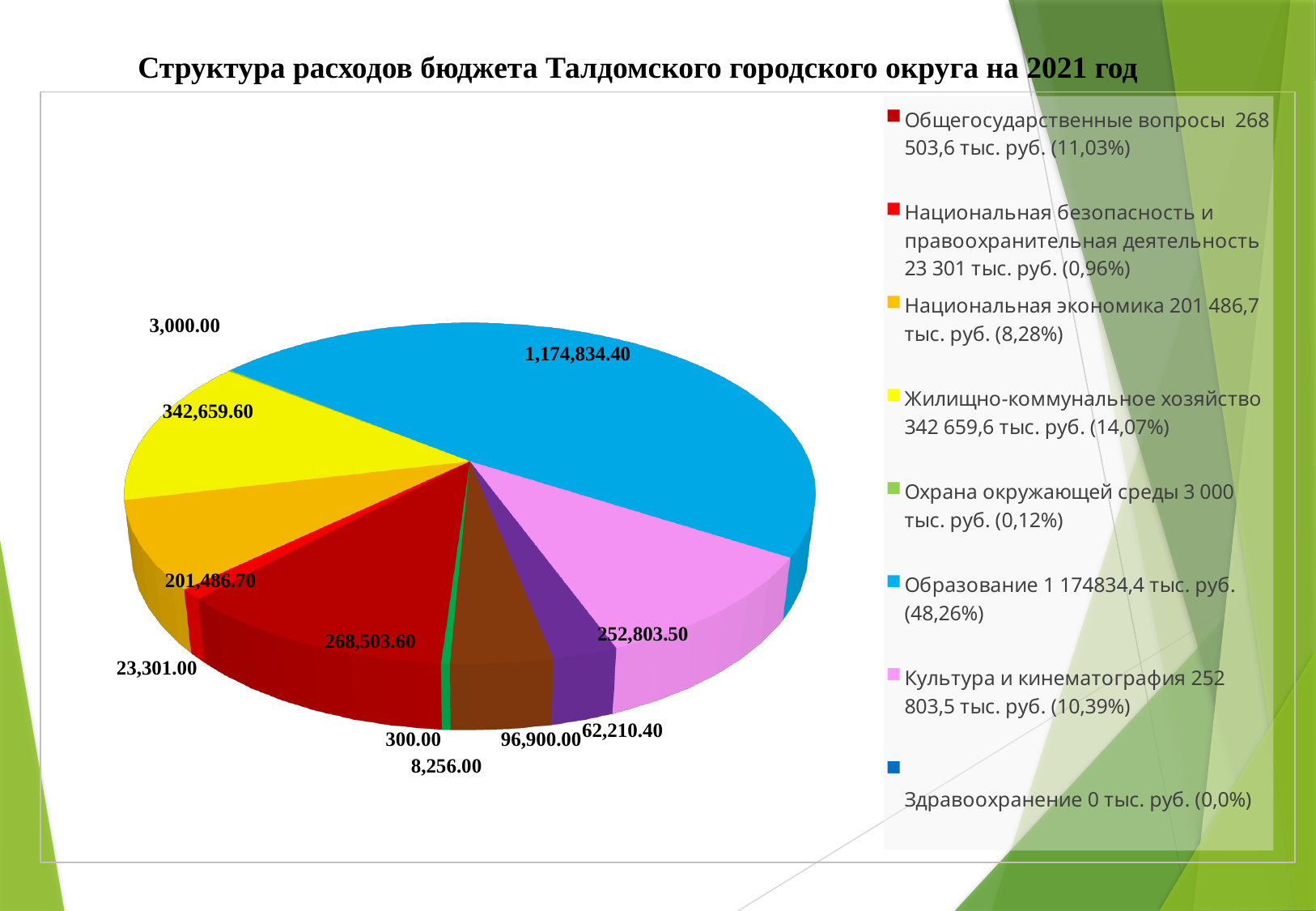
What value is labelled on the slice for Охрана окружающей среды? 3,000.00 What kind of chart is shown on the slide? pie chart According to the legend, what share of the pie does Жилищно-коммунальное хозяйство represent? 14,07% What value is labelled on the slice for Образование? 1,174,834.40 What is the title of the chart? Структура расходов бюджета Талдомского городского округа на 2021 год Which is larger, the slice for Общегосударственные вопросы or the slice for Культура и кинематография? Общегосударственные вопросы What value is labelled on the slice for Культура и кинематография? 252,803.50 What is the difference between the labelled values for Жилищно-коммунальное хозяйство and Общегосударственные вопросы? 74,156.00 Which category has the largest slice of the pie? Образование What value is labelled on the slice for Жилищно-коммунальное хозяйство? 342,659.60 What value is labelled on the slice for Национальная экономика? 201,486.70 According to the legend, what share of the pie does Образование represent? 48,26%